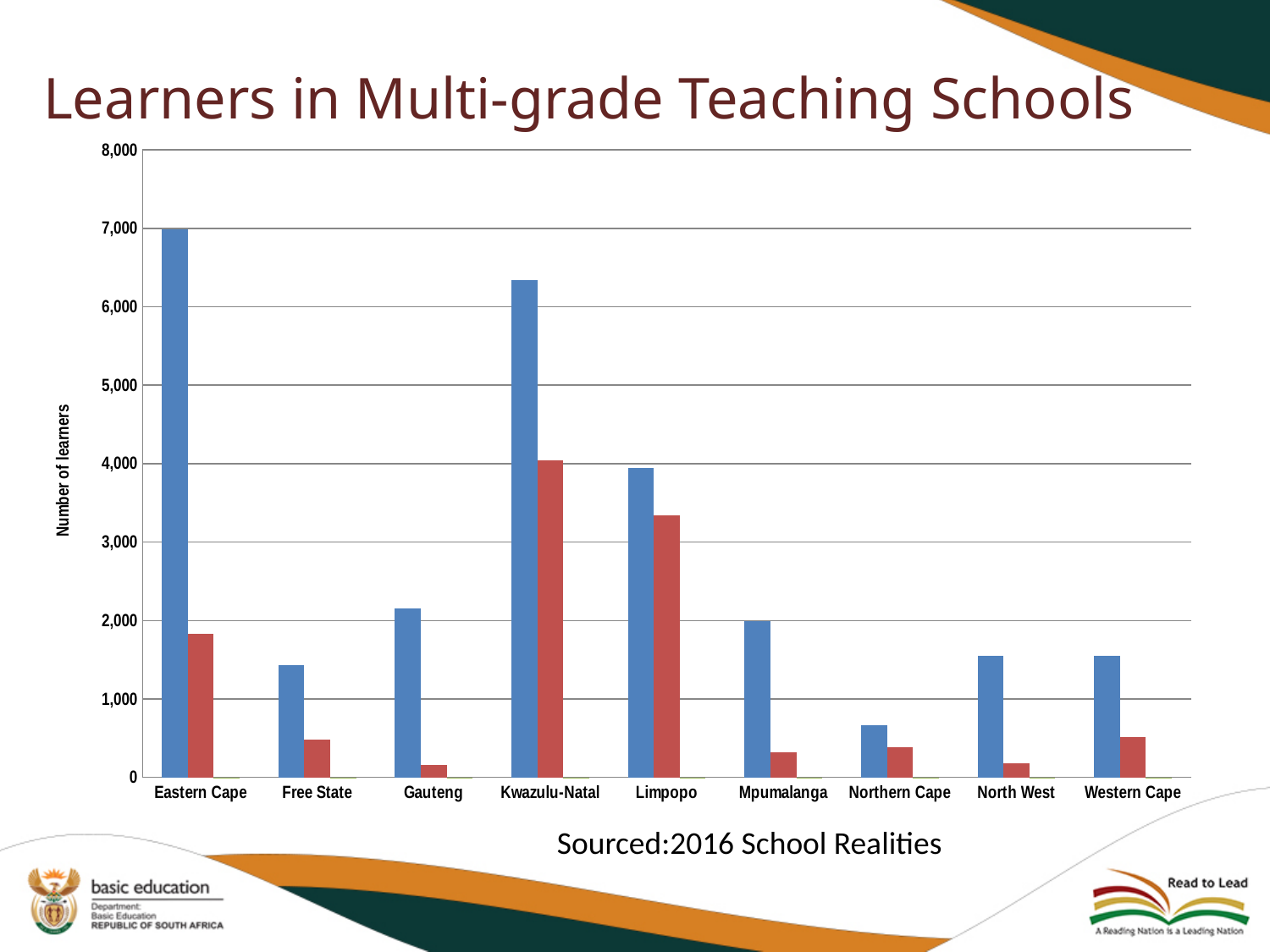
Which province has the shortest blue bar? Northern Cape What kind of chart is shown on the slide? bar chart Which province has the shortest red bar? Gauteng What is the label on the vertical axis of the chart? Number of learners Is the blue bar for Northern Cape greater or less than 1,000? less What is the title of the chart? Learners in Multi-grade Teaching Schools Is the blue bar for Kwazulu-Natal greater or less than 6,000? greater Which province has the tallest blue bar? Eastern Cape How many provinces (categories) are shown on the x axis? 9 Is the red bar for Limpopo greater or less than 3,000? greater Which is larger, the blue bar for Kwazulu-Natal or the blue bar for Limpopo? Kwazulu-Natal Which province has the tallest red bar? Kwazulu-Natal